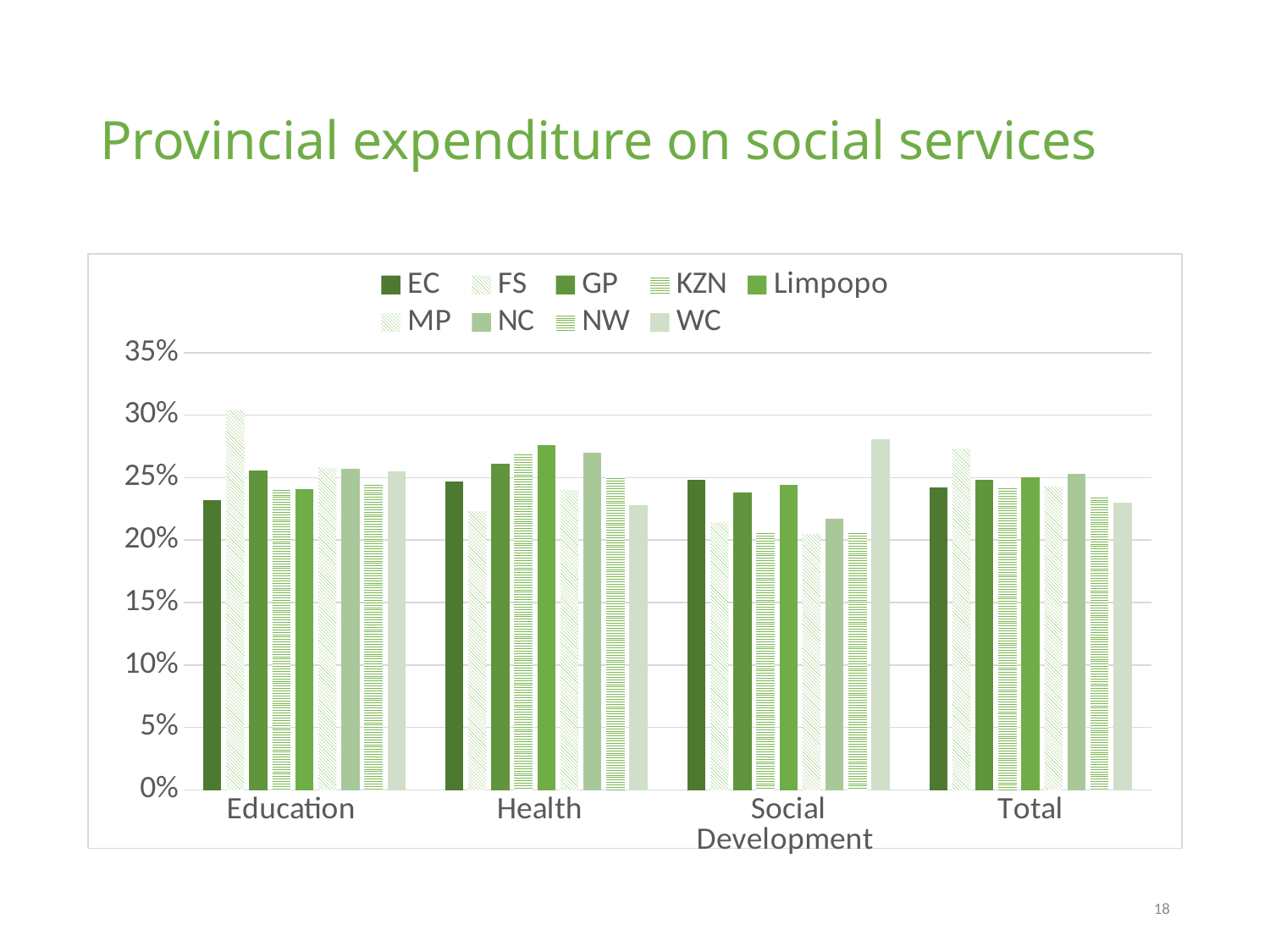
Is the value for KZN in Social Development greater or less than 25%? less In Social Development, which is larger, the value for WC or the value for MP? WC What is the title of the chart? Provincial expenditure on social services What kind of chart is shown on the slide? bar chart Which province has the lowest value for Education? EC Which province has the highest value for Education? FS How many categories are shown on the x axis? 4 Which province has the highest value for Social Development? WC Is the value for FS in Education greater or less than 25%? greater Which province has the highest value for Total? FS How many series does the legend list? 9 Is the value for WC in Social Development greater or less than 25%? greater